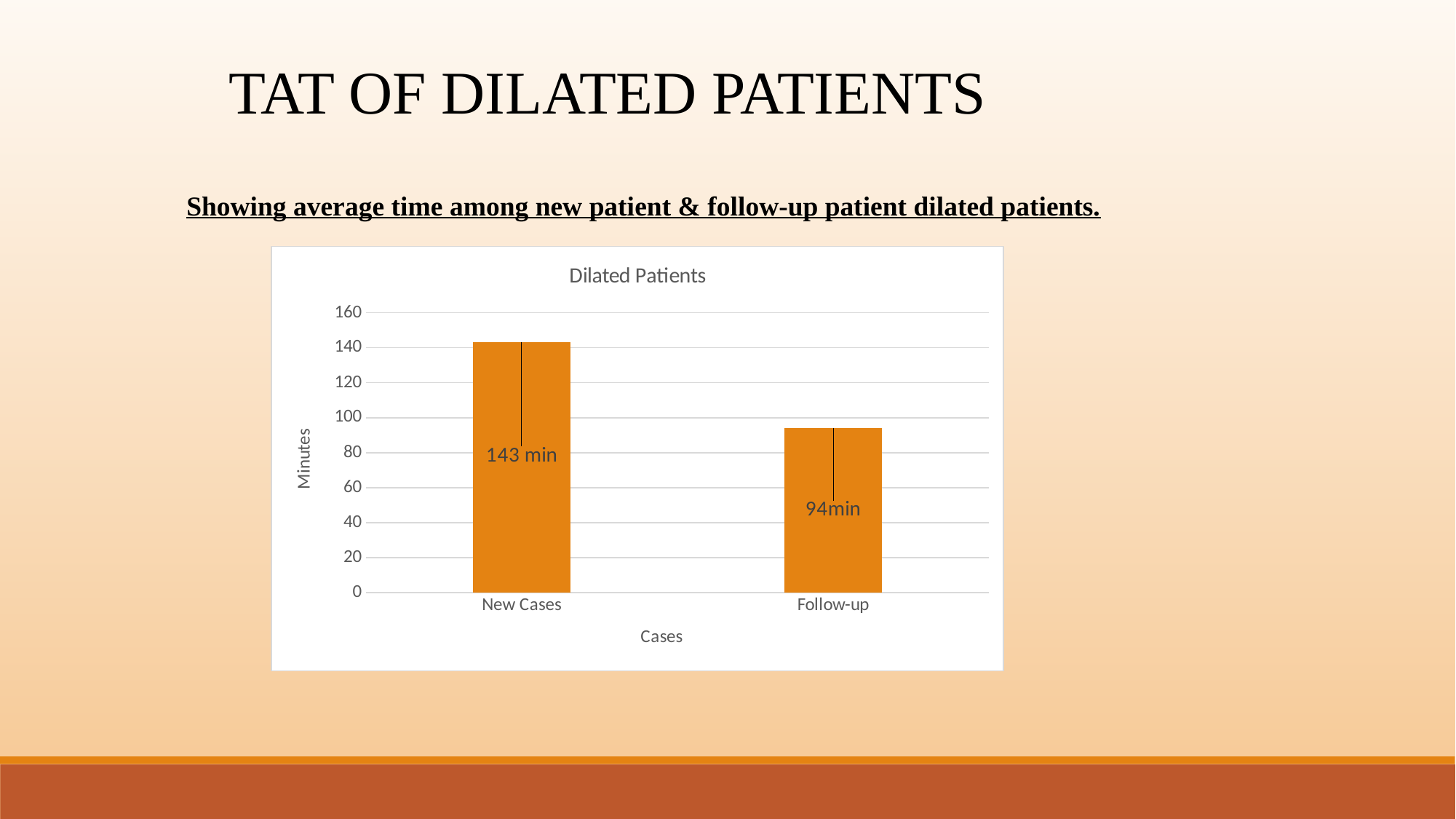
How many categories are shown on the x axis? 2 What kind of chart is shown? bar chart Is the value for Follow-up greater or less than 100? less What is the value for Follow-up? 94min What is the difference in minutes between New Cases and Follow-up? 49 min Which is larger, the value for New Cases or the value for Follow-up? New Cases What is the label of the y axis? Minutes Which category has the highest value? New Cases What is the value for New Cases? 143 min What is the title of the chart? Dilated Patients Which category has the lowest value? Follow-up Is the value for New Cases greater or less than 140? greater